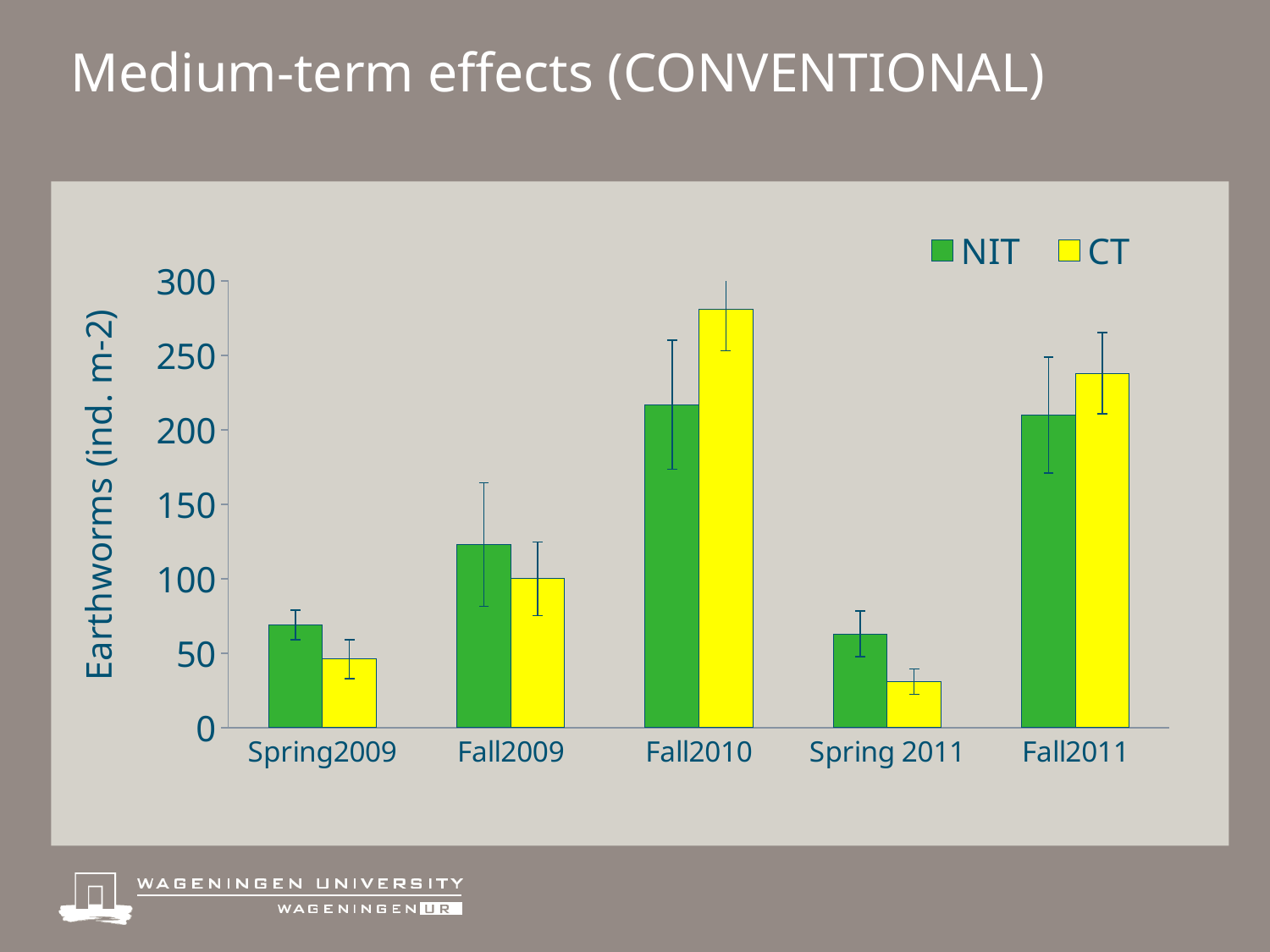
What is the label of the y axis? Earthworms (ind. m-2) Is the NIT value for Fall2011 greater or less than 150? greater How many categories are shown on the x axis? 5 In Fall2010, which series has the larger value, NIT or CT? CT Is the CT value for Fall2010 greater or less than 250? greater In Spring 2011, which series has the larger value, NIT or CT? NIT What kind of chart is shown on the slide? bar chart In which category is the CT bar the highest? Fall2010 How many series does the legend list? 2 In which category is the CT bar the lowest? Spring 2011 In which category is the NIT bar the highest? Fall2010 Is the CT value for Spring 2011 greater or less than 50? less